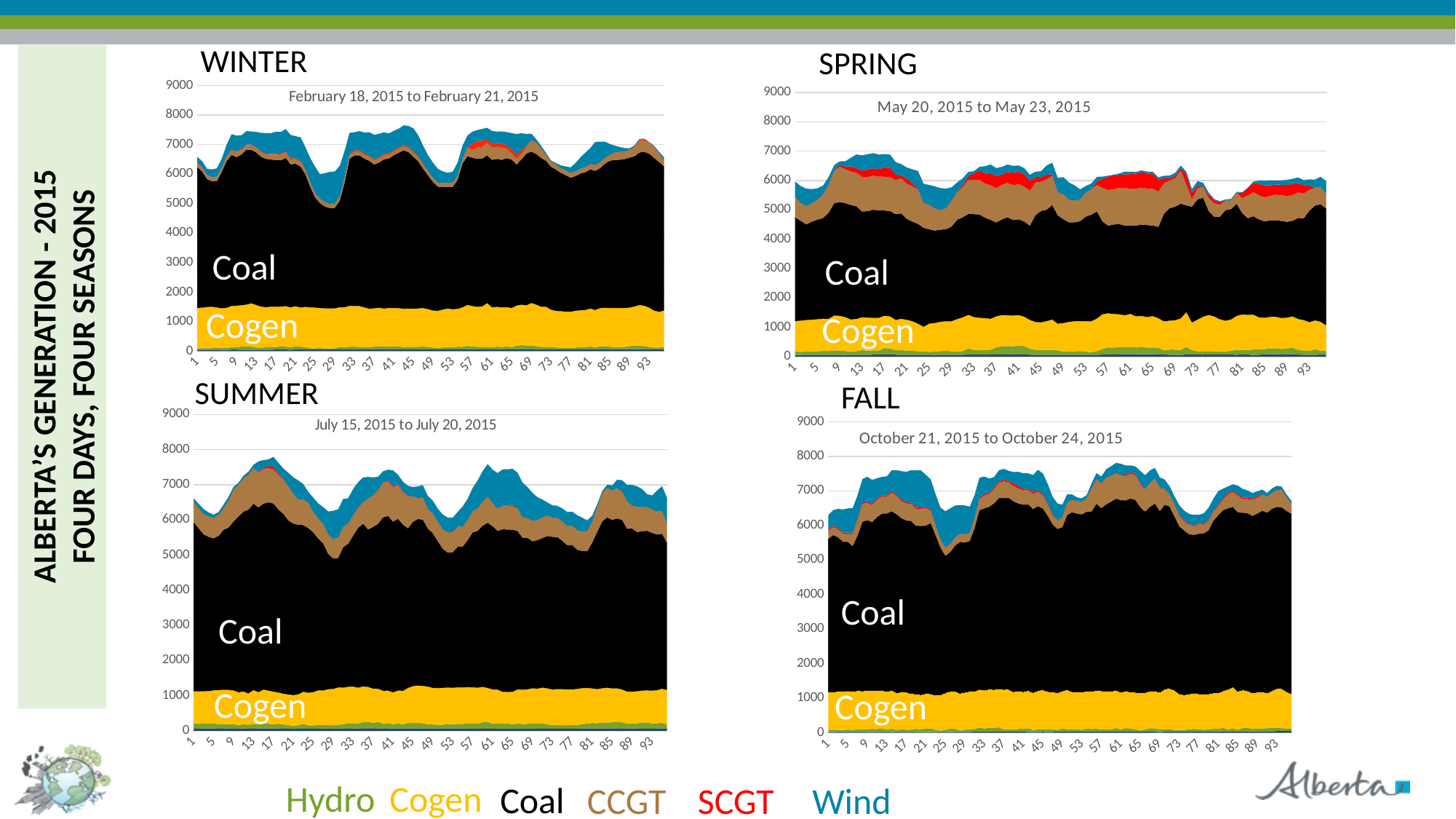
What kind of chart is the WINTER chart? Stacked area chart In the SUMMER chart, is the highest total generation greater or less than 8000? less Which series is shown in red in the legend? SCGT In the WINTER chart, is the top of the Cogen layer greater or less than 2000 at every point? less How many charts are shown on the slide? 4 What date range does the FALL chart cover? October 21, 2015 to October 24, 2015 In the FALL chart, is the lowest total generation greater or less than 4000? greater Which of the four seasonal charts has the lowest peak total generation? SPRING In the SUMMER chart, which series occupies the largest area? Coal How many series does the legend at the bottom of the slide list? 6